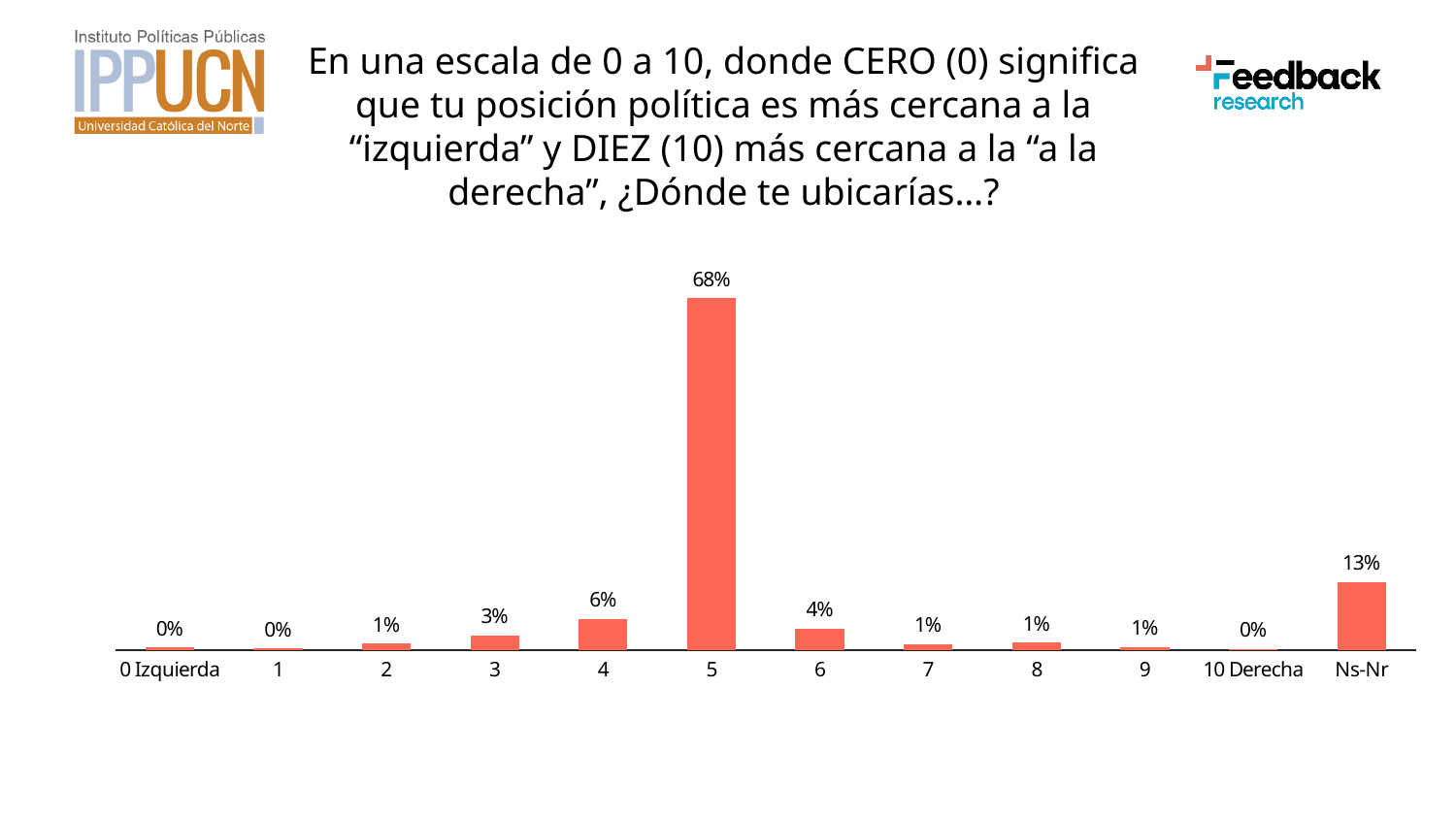
What is the combined value of categories 0 Izquierda, 1, 2, 3 and 4? 10% What percentage of respondents answered Ns-Nr? 13% What is the value for category 4? 6% Which category has the highest value? 5 What is the difference between the value for 5 and the value for Ns-Nr? 55% What is the value for 10 Derecha? 0% What kind of chart is shown on the slide? Bar chart What colour are the bars in the chart? Orange-red What is the difference between the value for 4 and the value for 6? 2% What percentage of respondents placed themselves at 5 on the scale? 68% Which is larger, the value for 3 or the value for 6? 6 How many categories are shown on the x axis? 12